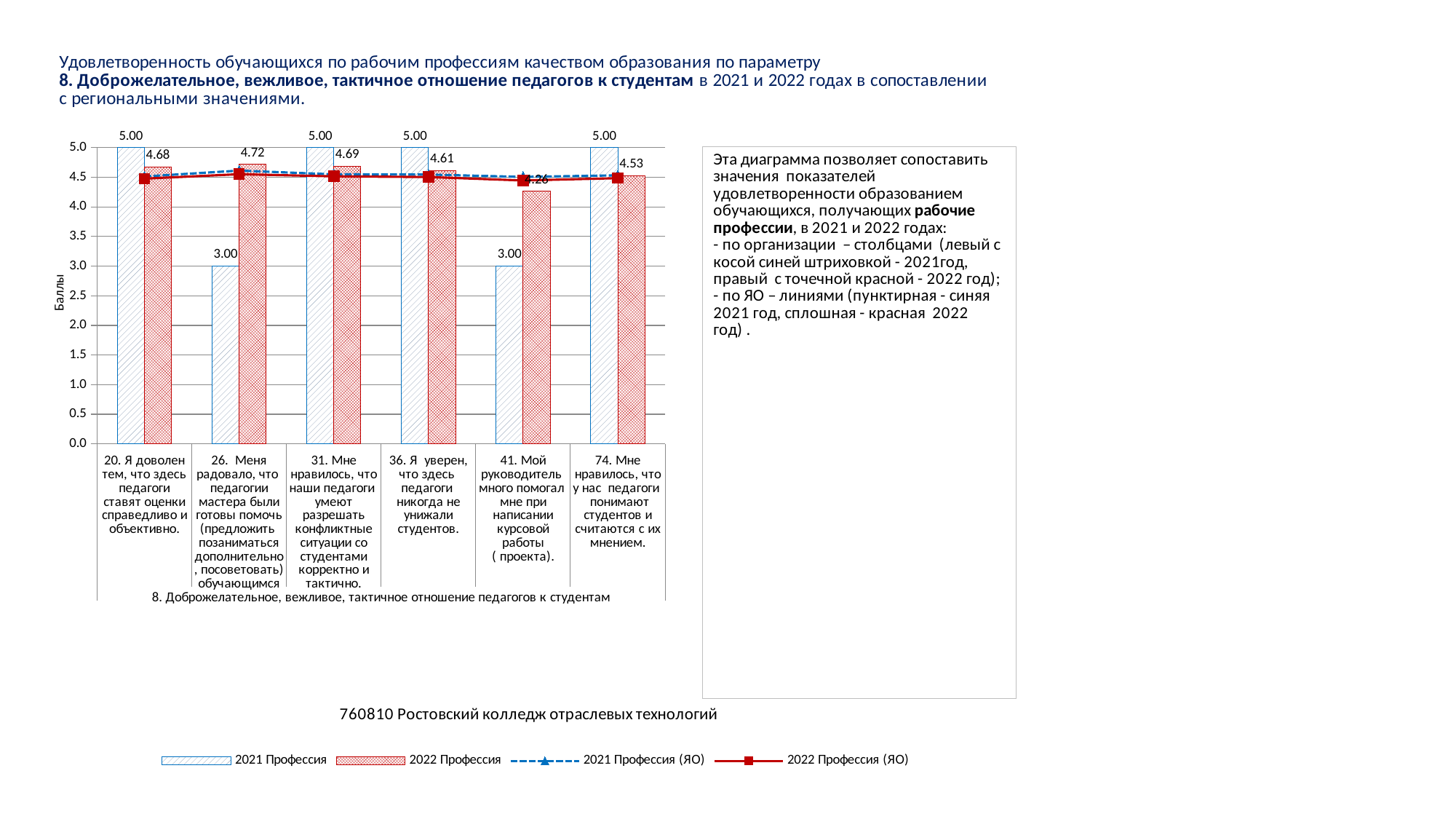
How many series does the chart legend list? 4 How many question categories are shown on the x axis of the chart? 6 What is the value of the 2022 Профессия bar for question 74 (Мне нравилось, что у нас педагоги понимают студентов и считаются с их мнением)? 4.53 For question 26, what is the difference between the 2022 Профессия value and the 2021 Профессия value? 1.72 Which question has the lowest 2022 Профессия value? 41. Мой руководитель много помогал мне при написании курсовой работы (4.26) What is the value of the 2021 Профессия bar for question 26 (Меня радовало, что педагогии мастера были готовы помочь...)? 3.00 Is the 2022 Профессия (ЯО) line value for question 41 greater or less than 4.0? greater What is the value of the 2022 Профессия bar for question 41 (Мой руководитель много помогал мне при написании курсовой работы)? 4.26 What is the value of the 2022 Профессия bar for question 20 (Я доволен тем, что здесь педагоги ставят оценки справедливо и объективно)? 4.68 For question 20, which is larger: the 2021 Профессия bar or the 2022 Профессия bar? 2021 Профессия What is the title of the vertical axis of the chart? Баллы Which question has the highest 2022 Профессия value? 26. Меня радовало, что педагогии мастера были готовы помочь (4.72)